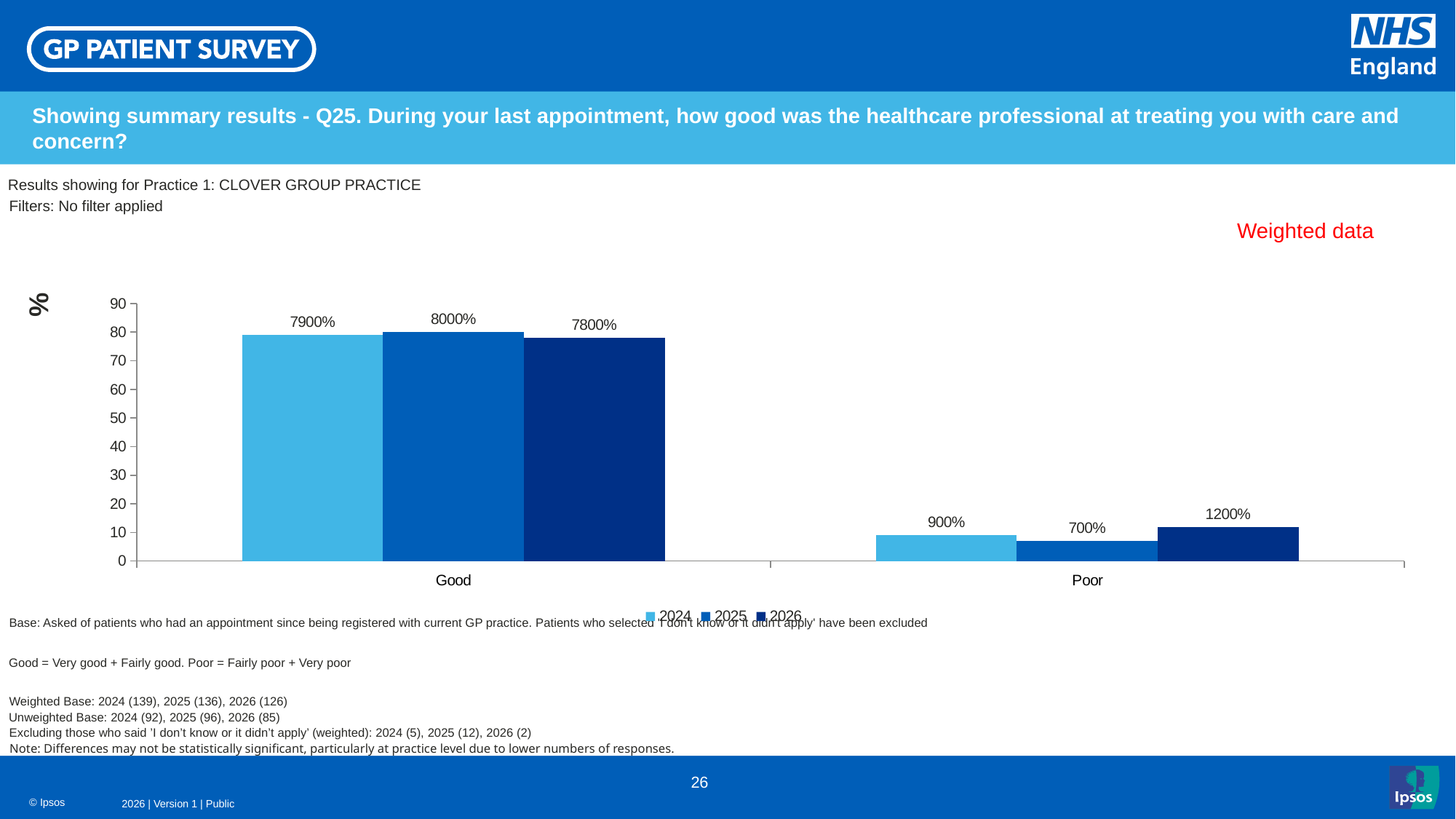
What is the data label shown for the 2025 bar in the Poor category? 700% What is the data label shown for the 2024 bar in the Good category? 7900% Is the value for the 2026 bar in the Good category greater or less than 70 on the axis? greater Which is larger in the Poor category, the 2024 bar or the 2026 bar? 2026 What is the data label shown for the 2026 bar in the Poor category? 1200% How many categories are shown on the x axis? 2 What is the data label shown for the 2025 bar in the Good category? 8000% Which year has the lowest bar in the Poor category? 2025 How many series does the legend list? 3 Is the value for the 2024 bar in the Poor category greater or less than 20 on the axis? less Which year has the highest bar in the Good category? 2025 What kind of chart is shown on the slide? Bar chart